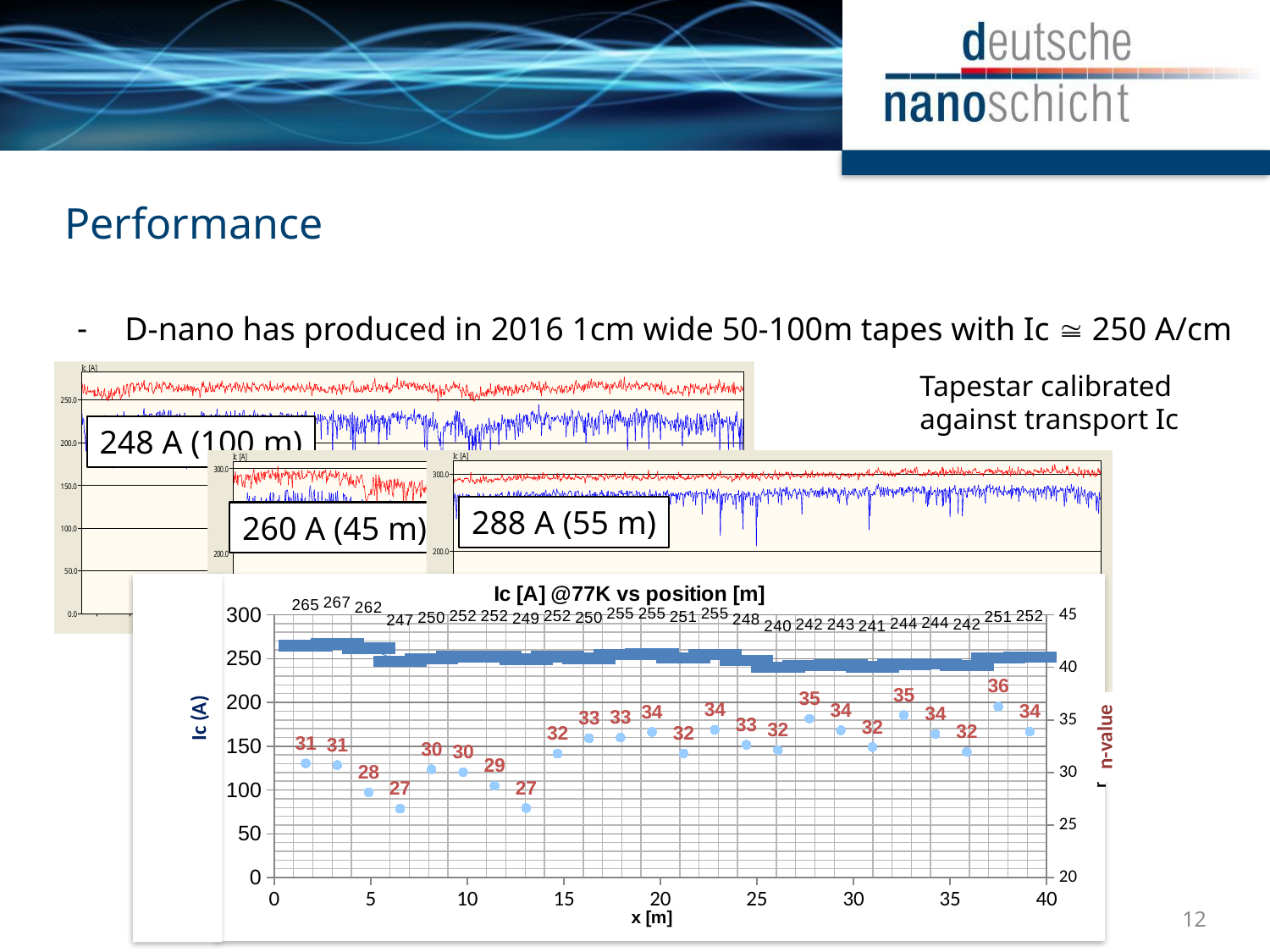
In the chart titled "Ic [A] @77K vs position [m]", what is the maximum value shown on the right-hand n-value axis? 45 In the chart titled "Ic [A] @77K vs position [m]", what is the label of the horizontal axis? x [m] In the chart titled "Ic [A] @77K vs position [m]", what is the highest Ic value labelled? 267 In the chart titled "Ic [A] @77K vs position [m]", what is the difference between the highest labelled Ic value (267) and the lowest labelled Ic value (240)? 27 According to the label on the Tapestar screenshot at the top left, what Ic value is given for the 100 m tape? 248 A In the chart titled "Ic [A] @77K vs position [m]", what is the lowest n-value labelled? 27 In the chart titled "Ic [A] @77K vs position [m]", what is the highest n-value labelled? 36 In the chart titled "Ic [A] @77K vs position [m]", is the first Ic value (265) greater or less than 250? greater In the chart titled "Ic [A] @77K vs position [m]", how many Ic data labels are shown along the top of the plot? 24 In the chart titled "Ic [A] @77K vs position [m]", what is the label of the left vertical axis? Ic (A) In the chart titled "Ic [A] @77K vs position [m]", are the n-value points near x = 5 m greater or less than 30? less In the chart titled "Ic [A] @77K vs position [m]", what is the lowest Ic value labelled? 240